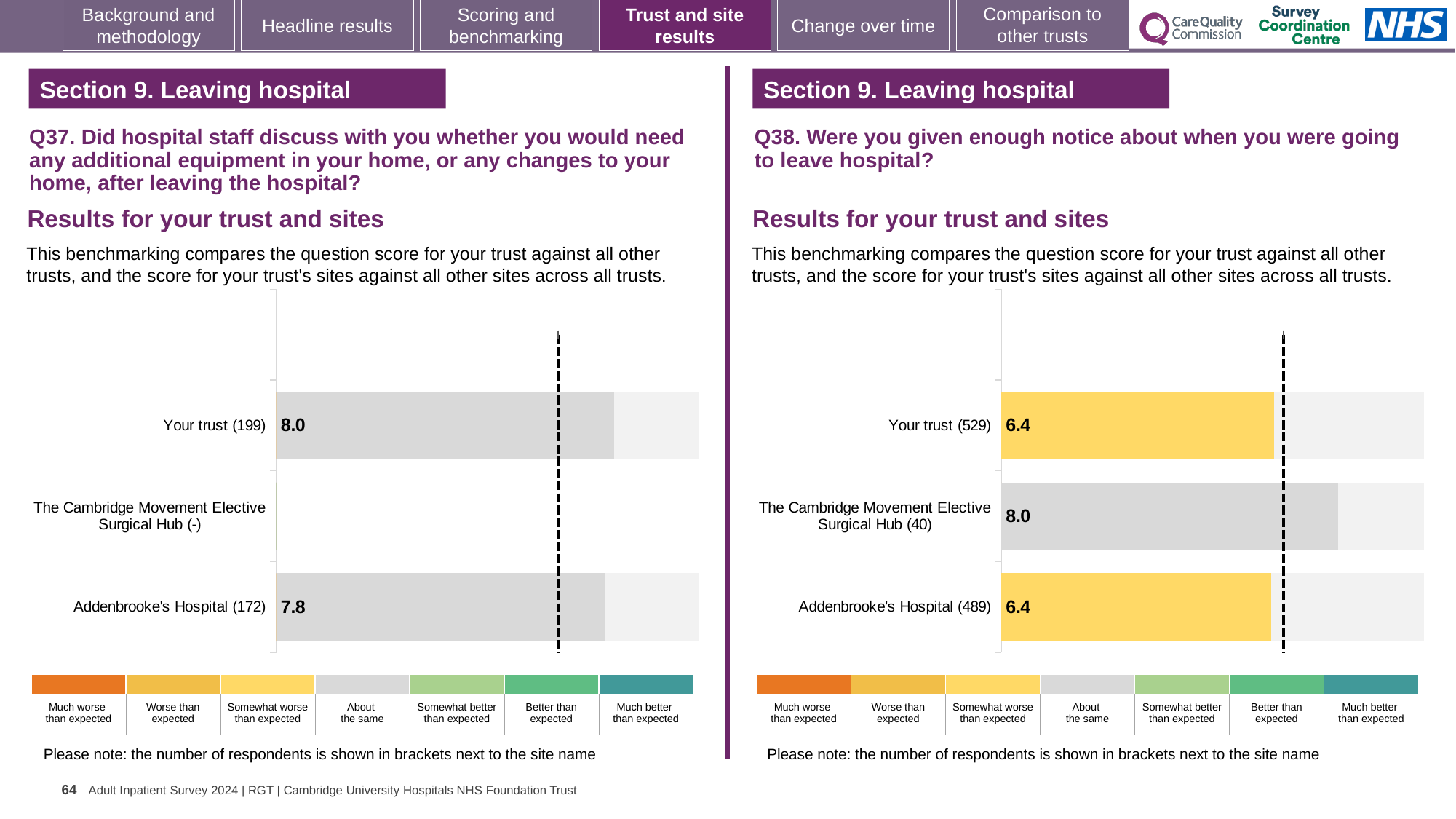
In the Q37 chart on the left, how many respondents are shown in brackets for Addenbrooke's Hospital? 172 In the Q37 chart on the left, what is the score for Your trust? 8.0 In the Q38 chart on the right, which benchmark category does the yellow colour of the Your trust bar represent? Somewhat worse than expected In the Q38 chart on the right, how many respondents are shown in brackets for Your trust? 529 How many categories (rows) are listed in the Q38 chart on the right? 3 In the Q37 chart on the left, what is the difference between the scores for Your trust and Addenbrooke's Hospital? 0.2 In the Q38 chart on the right, which site or trust has the highest score? The Cambridge Movement Elective Surgical Hub What kind of chart is used in the Q37 chart on the left? Bar chart In the Q38 chart on the right, what is the score for The Cambridge Movement Elective Surgical Hub? 8.0 In the Q37 chart on the left, what is the score for Addenbrooke's Hospital? 7.8 In the Q38 chart on the right, what is the score for Addenbrooke's Hospital? 6.4 In the Q38 chart on the right, what is the difference between the scores for The Cambridge Movement Elective Surgical Hub and Your trust? 1.6